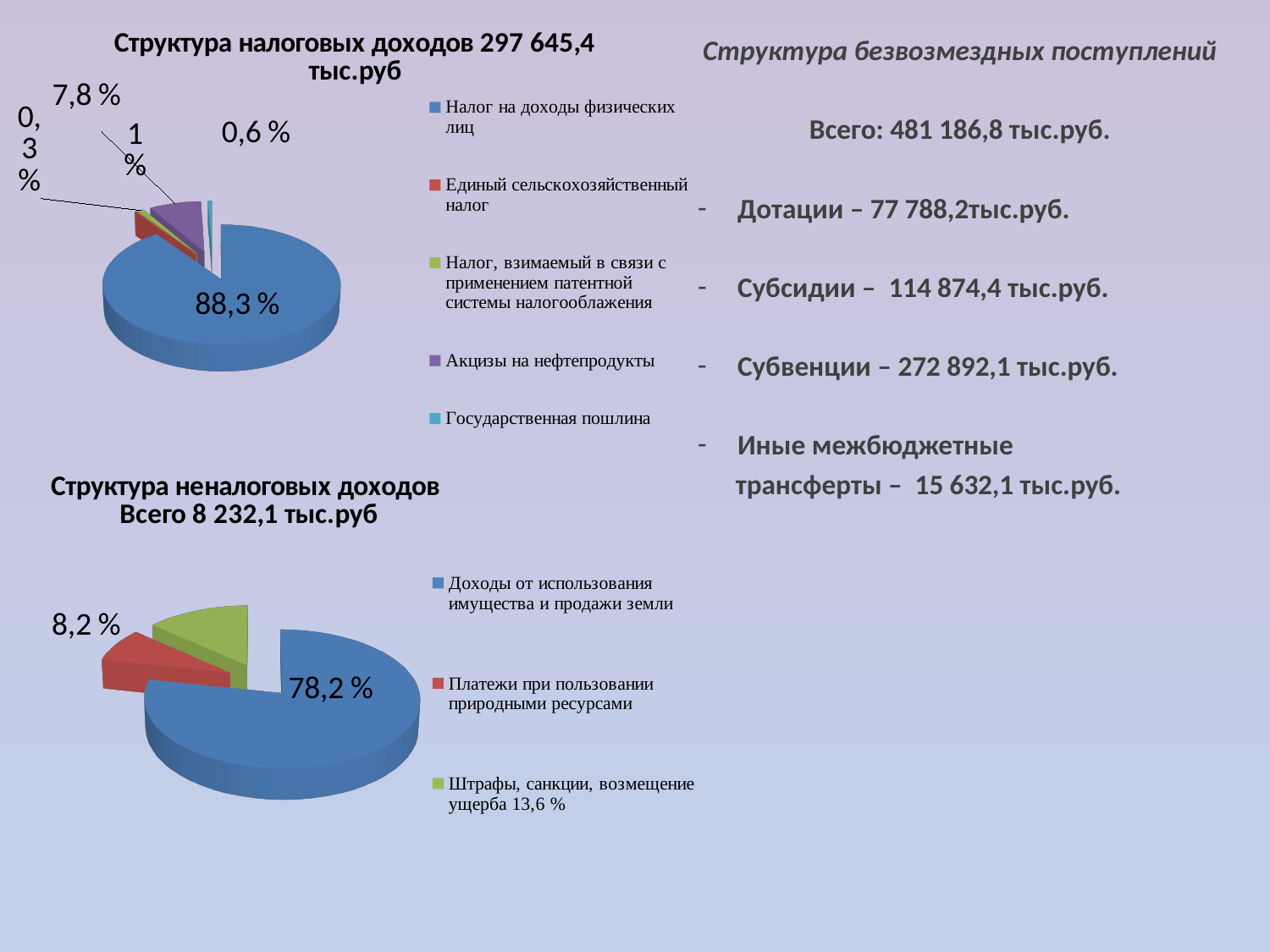
In the chart 'Структура неналоговых доходов', what share is shown for 'Штрафы, санкции, возмещение ущерба'? 13,6 % In the chart 'Структура неналоговых доходов', which category has the smallest share? Платежи при пользовании природными ресурсами In the chart 'Структура налоговых доходов', what share is shown for 'Налог на доходы физических лиц'? 88,3 % In the chart 'Структура налоговых доходов', which category has the largest share? Налог на доходы физических лиц What total amount is given in the title of the chart 'Структура налоговых доходов'? 297 645,4 тыс.руб In the chart 'Структура неналоговых доходов', what share is shown for 'Доходы от использования имущества и продажи земли'? 78,2 % In the chart 'Структура неналоговых доходов', what is the difference between the shares of 'Доходы от использования имущества и продажи земли' and 'Штрафы, санкции, возмещение ущерба'? 64,6 % How many categories does the chart 'Структура неналоговых доходов' show? 3 In the chart 'Структура налоговых доходов', what share is shown for 'Акцизы на нефтепродукты'? 7,8 % What type of chart is 'Структура налоговых доходов'? Pie chart In the chart 'Структура неналоговых доходов', what share is shown for 'Платежи при пользовании природными ресурсами'? 8,2 % How many entries does the legend of the chart 'Структура налоговых доходов' list? 5